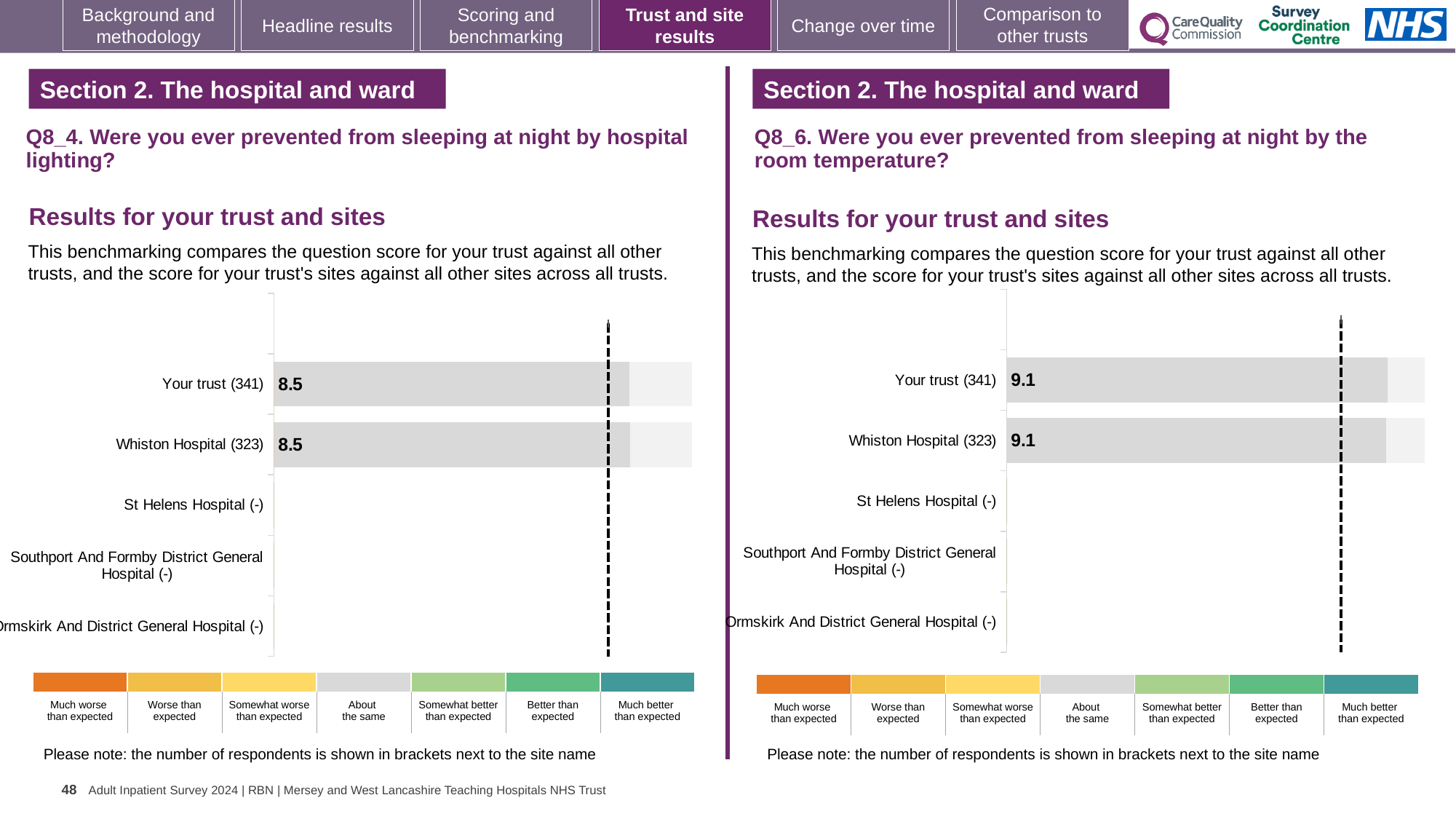
On the left chart (Q8_4, hospital lighting), what is the score for Whiston Hospital (323)? 8.5 On the right chart (Q8_6, room temperature), what is the score for Whiston Hospital (323)? 9.1 On the left chart (Q8_4, hospital lighting), which sites have no score shown (marked with a dash)? St Helens Hospital, Southport And Formby District General Hospital, Ormskirk And District General Hospital What kind of chart is used on the left (Q8_4, hospital lighting)? Bar chart On the left chart (Q8_4, hospital lighting), what is the score for Your trust (341)? 8.5 How many respondents are shown in brackets for Whiston Hospital on the right chart (Q8_6, room temperature)? 323 How many site/trust categories are listed on the right chart (Q8_6, room temperature)? 5 On the right chart (Q8_6, room temperature), what is the difference between the scores for Your trust and Whiston Hospital? 0 On the right chart (Q8_6, room temperature), what is the score for Your trust (341)? 9.1 How many benchmark categories does the colour legend below the left chart (Q8_4, hospital lighting) show? 7 On the left chart (Q8_4, hospital lighting), what is the difference between the scores for Your trust and Whiston Hospital? 0 How many site/trust categories are listed on the left chart (Q8_4, hospital lighting)? 5